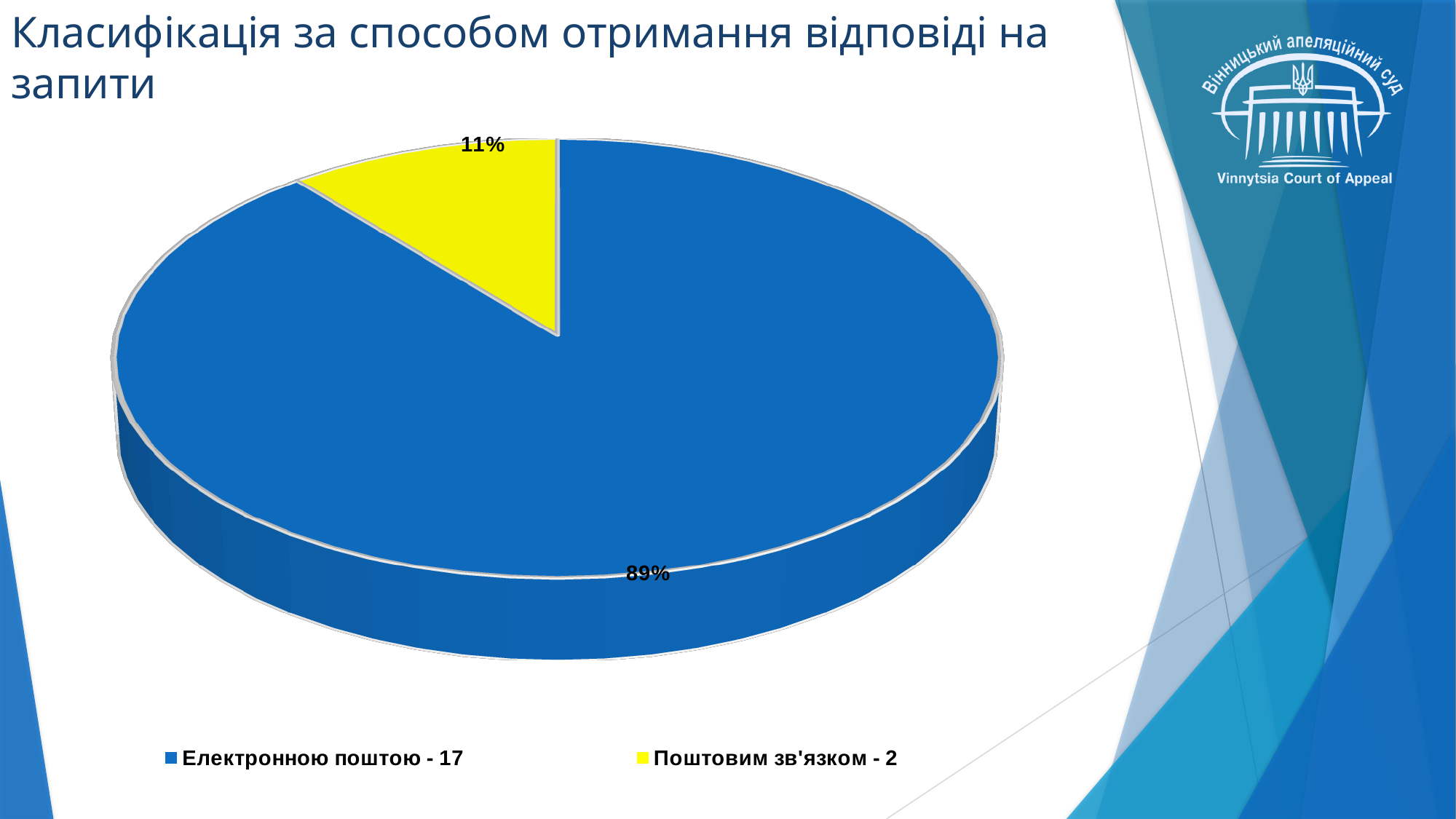
What is the title of the slide containing the chart? Класифікація за способом отримання відповіді на запити How many entries does the legend list? 2 What is the difference in percentage points between the 89% slice and the 11% slice? 78 Which category has the smallest slice of the pie? Поштовим зв'язком - 2 Which is larger: the share for "Електронною поштою" or the share for "Поштовим зв'язком"? Електронною поштою Is the share for "Електронною поштою" greater or less than 50%? greater What colour is the slice for "Поштовим зв'язком - 2"? yellow What percentage share does the slice for "Поштовим зв'язком - 2" have? 11% What kind of chart is shown on the slide? pie chart Which category has the largest slice of the pie? Електронною поштою - 17 How many slices does the pie chart have? 2 What percentage share does the slice for "Електронною поштою - 17" have? 89%